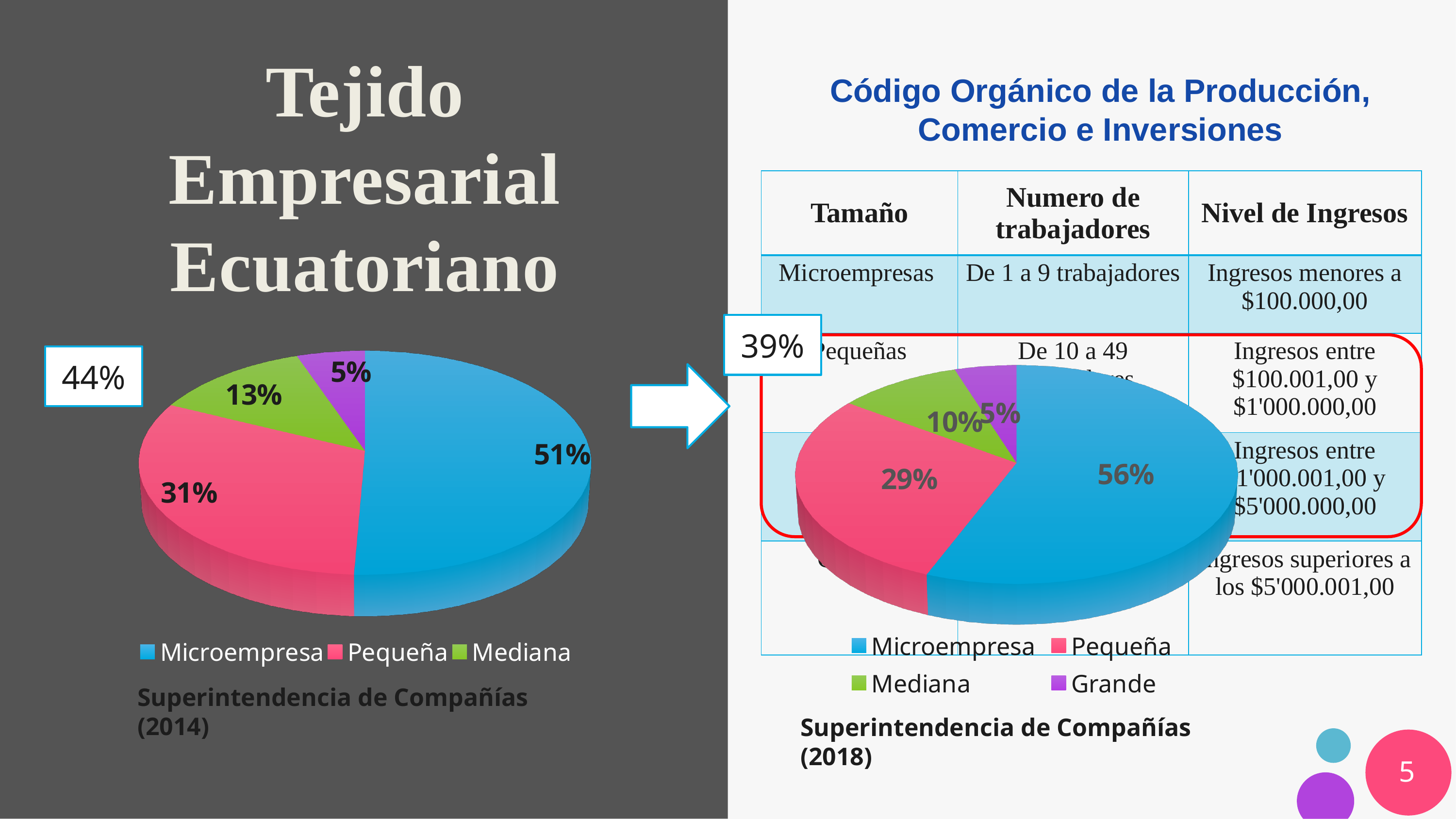
In the right pie chart (2018), what is the difference between the Microempresa and Pequeña shares? 27% In the right pie chart (2018), which category has the largest share? Microempresa In the right pie chart (2018), what percentage is shown for Microempresa? 56% In the right pie chart (2018), which category has the smallest share? Grande In the right pie chart (2018), what percentage is shown for Grande? 5% How many entries does the legend of the right pie chart (2018) list? 4 In the left pie chart (2014), what percentage is shown for Pequeña? 31% In the left pie chart (2014), which is larger, the Pequeña share or the Mediana share? Pequeña What type of chart is shown on the left side of the slide? Pie chart In the left pie chart (2014), what percentage is shown for Microempresa? 51% In the left pie chart (2014), what percentage is shown for Mediana? 13% In the right pie chart (2018), what colour is the Mediana slice? Green